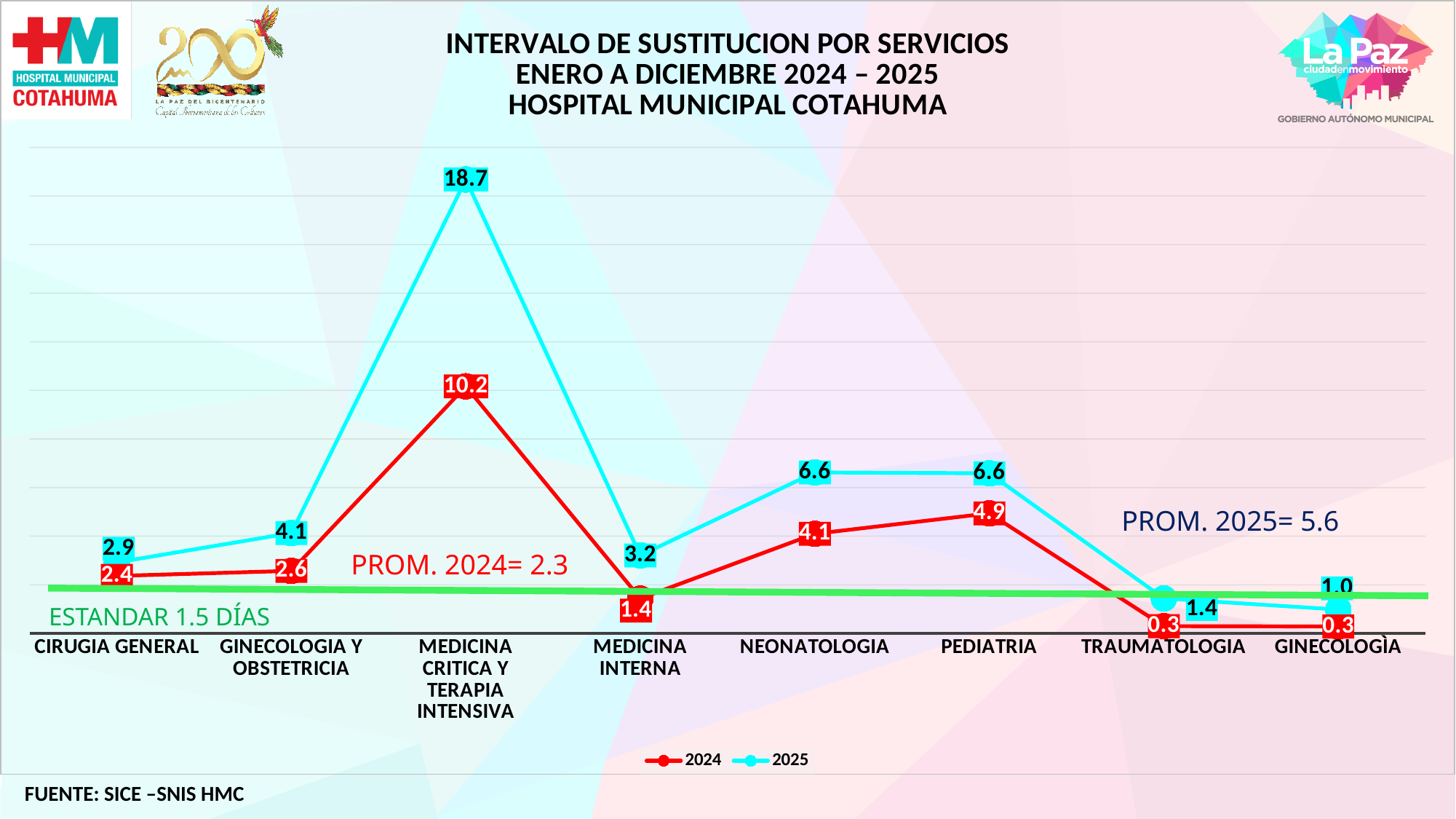
What standard value is indicated by the green line on the chart? 1.5 días Which is larger for Neonatologia, the 2024 value or the 2025 value? 2025 How many series does the legend list? 2 Which category has the lowest 2025 value? Ginecologia What is the 2024 value for Pediatria? 4.9 How many service categories are plotted along the x axis? 8 What is the 2025 value for Medicina Critica y Terapia Intensiva? 18.7 What is the difference between the 2025 values for Neonatologia and Medicina Interna? 3.4 What is the 2025 value for Ginecologia y Obstetricia? 4.1 What kind of chart is shown on the slide? line chart What is the difference between the 2025 and 2024 values for Medicina Critica y Terapia Intensiva? 8.5 Which category has the highest 2024 value? Medicina Critica y Terapia Intensiva